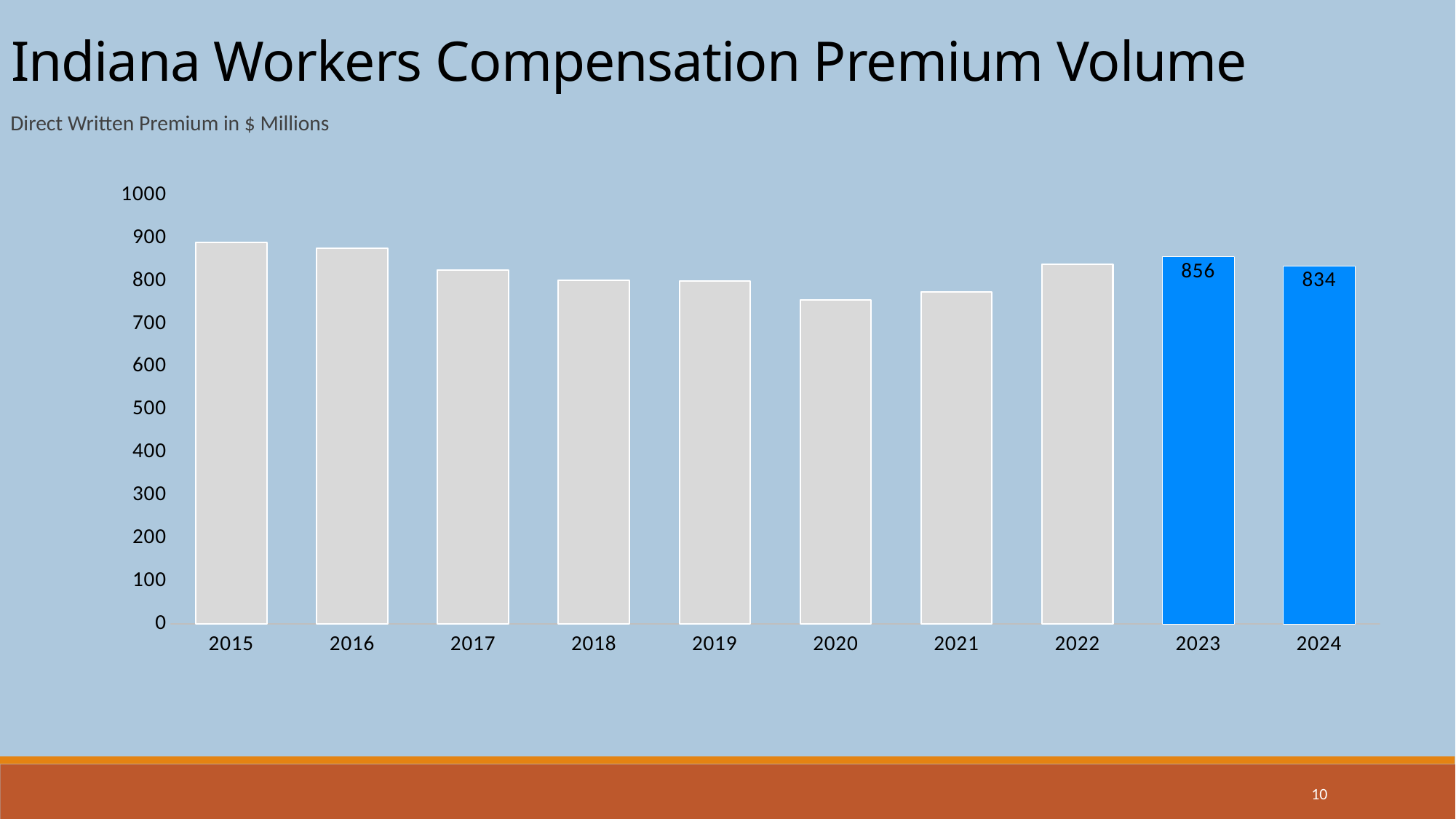
Is the value for 2020 greater or less than 800? less How many years are shown on the chart? 10 Which year has the lowest value? 2020 Do the values rise or fall from 2015 to 2020? fall What kind of chart is shown on the slide? bar chart Which is larger, the value for 2023 or the value for 2024? 2023 Is the value for 2015 greater or less than 800? greater What is the difference between the values for 2023 and 2024? 22 Is the value for 2021 greater or less than 800? less What is the value for 2024? 834 Which is larger, the value for 2015 or the value for 2020? 2015 What is the value for 2023? 856